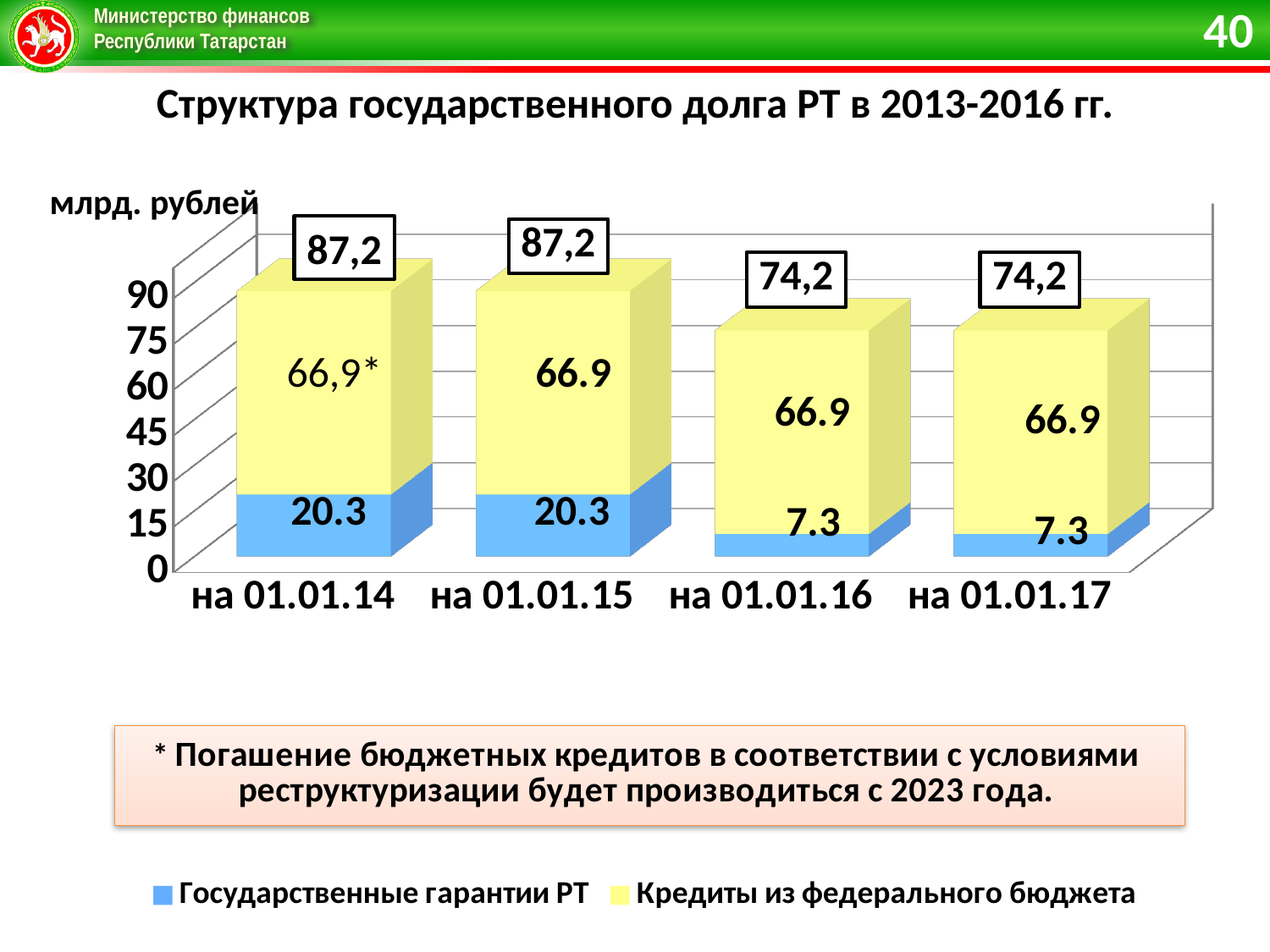
What unit of measurement is indicated for the chart? млрд. рублей What is the value of Государственные гарантии РТ on 01.01.17? 7.3 What is the total state debt shown above the bar for 01.01.17? 74,2 What is the total state debt shown above the bar for 01.01.15? 87,2 Do the total debt values rise or fall from 01.01.14 to 01.01.17? fall What is the value of Государственные гарантии РТ on 01.01.14? 20.3 What is the difference between the Государственные гарантии РТ values on 01.01.15 and 01.01.16? 13.0 Which is larger: the total debt on 01.01.14 or on 01.01.16? 01.01.14 What type of chart is shown on the slide? bar chart How many series does the legend list? 2 How many dates (categories) are shown on the x axis? 4 What is the value of Кредиты из федерального бюджета on 01.01.16? 66.9